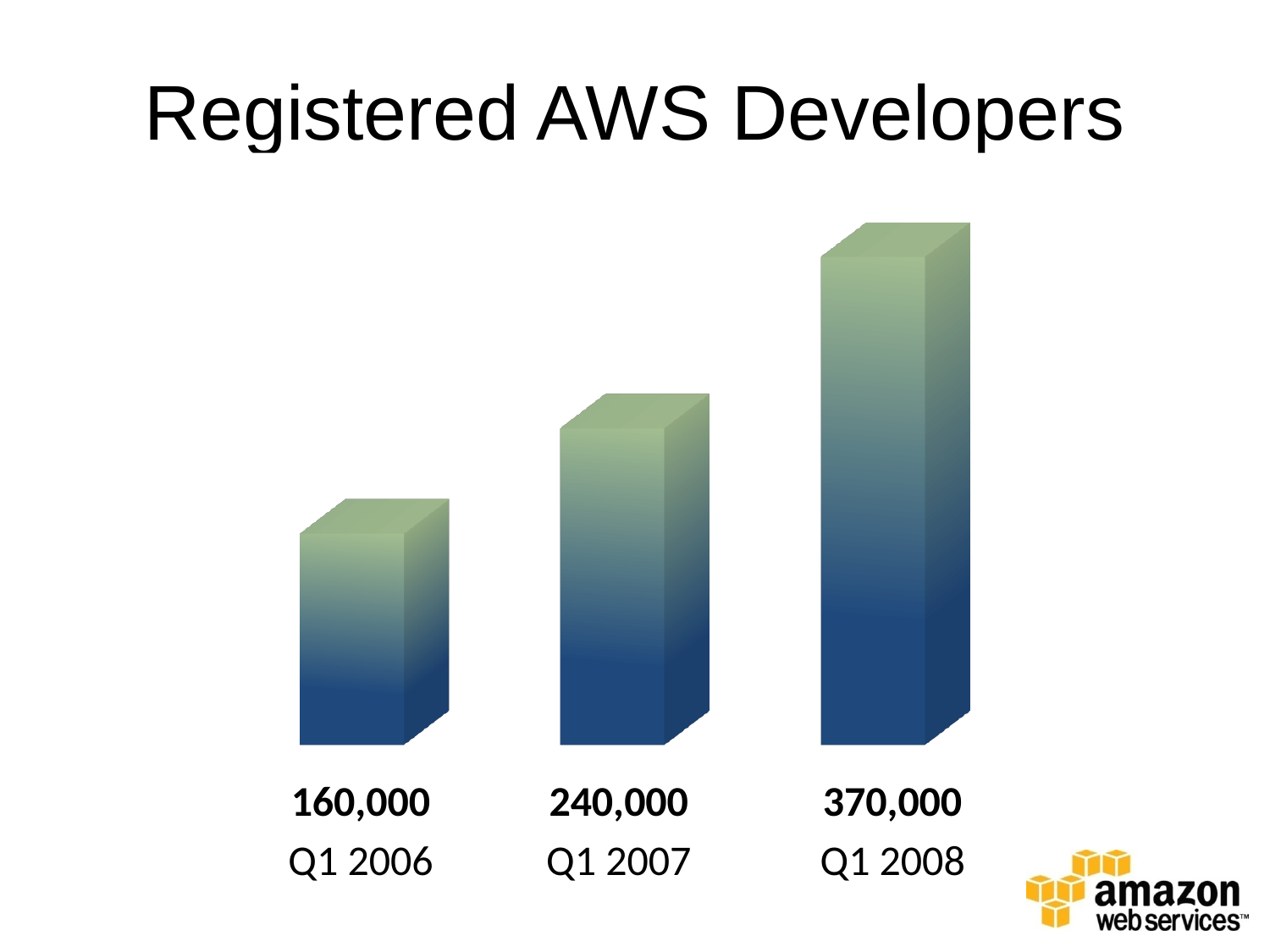
Which quarter has the highest number of registered AWS developers? Q1 2008 What kind of chart is shown on the slide? Bar chart What is the difference in registered AWS developers between Q1 2007 and Q1 2006? 80,000 What is the number of registered AWS developers in Q1 2007? 240,000 Do the values rise or fall from Q1 2006 to Q1 2008? Rise What is the number of registered AWS developers in Q1 2006? 160,000 Which quarter has the lowest number of registered AWS developers? Q1 2006 Which has more registered AWS developers, Q1 2006 or Q1 2007? Q1 2007 How many quarters are shown in the chart? 3 What is the number of registered AWS developers in Q1 2008? 370,000 What is the title of the chart? Registered AWS Developers What is the difference in registered AWS developers between Q1 2008 and Q1 2007? 130,000